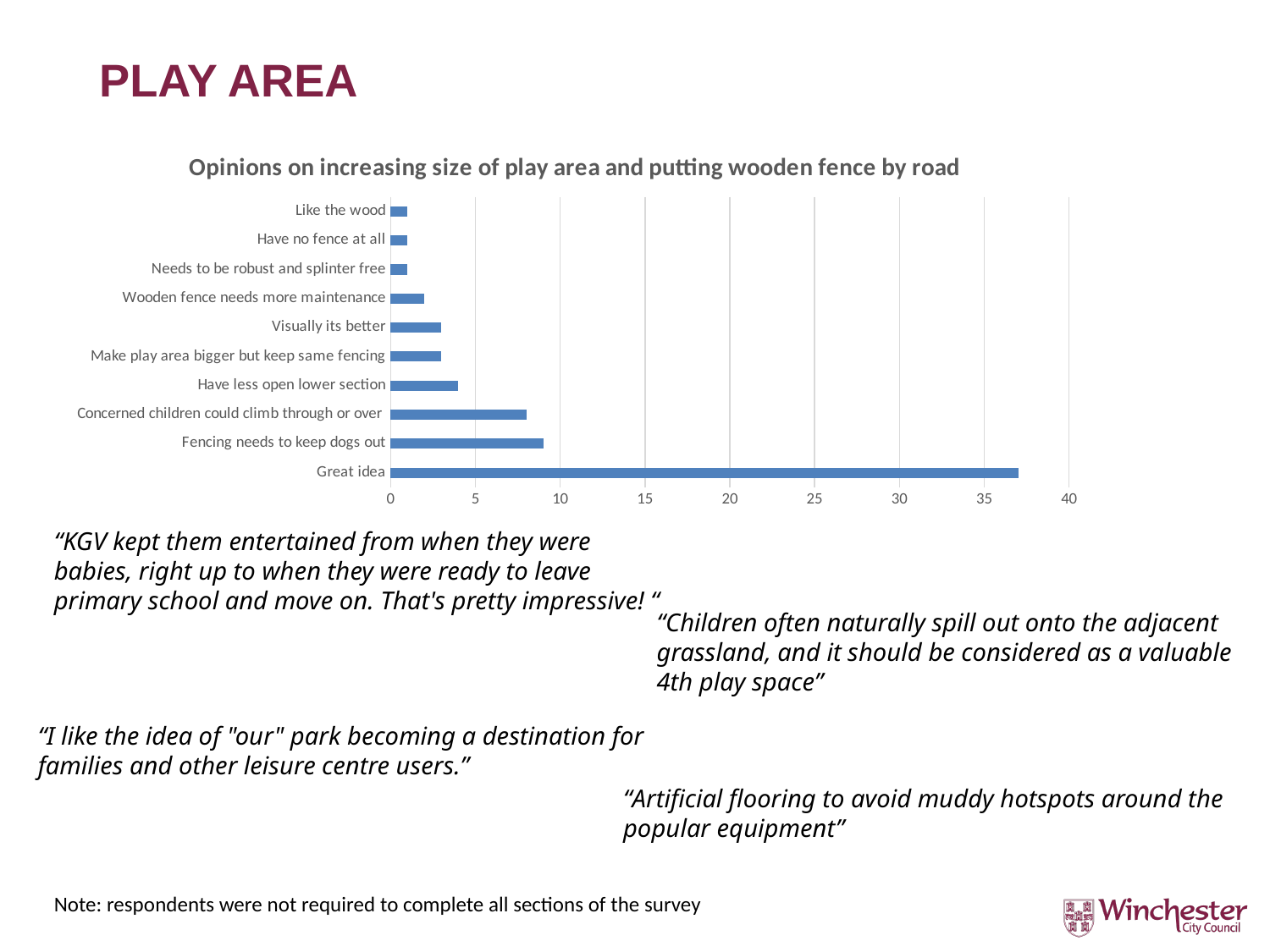
What is the title of the chart? Opinions on increasing size of play area and putting wooden fence by road Is the value for Fencing needs to keep dogs out greater or less than 10? less Is the value for Concerned children could climb through or over greater or less than 5? greater Which is larger: the value for Great idea or the value for Fencing needs to keep dogs out? Great idea What kind of chart is shown on the slide? bar chart Which is larger: the value for Concerned children could climb through or over or the value for Have less open lower section? Concerned children could climb through or over Is the value for Great idea greater or less than 35? greater How many categories are plotted in the chart? 10 What is the maximum value shown on the horizontal axis of the chart? 40 Which category has the highest value in the chart? Great idea